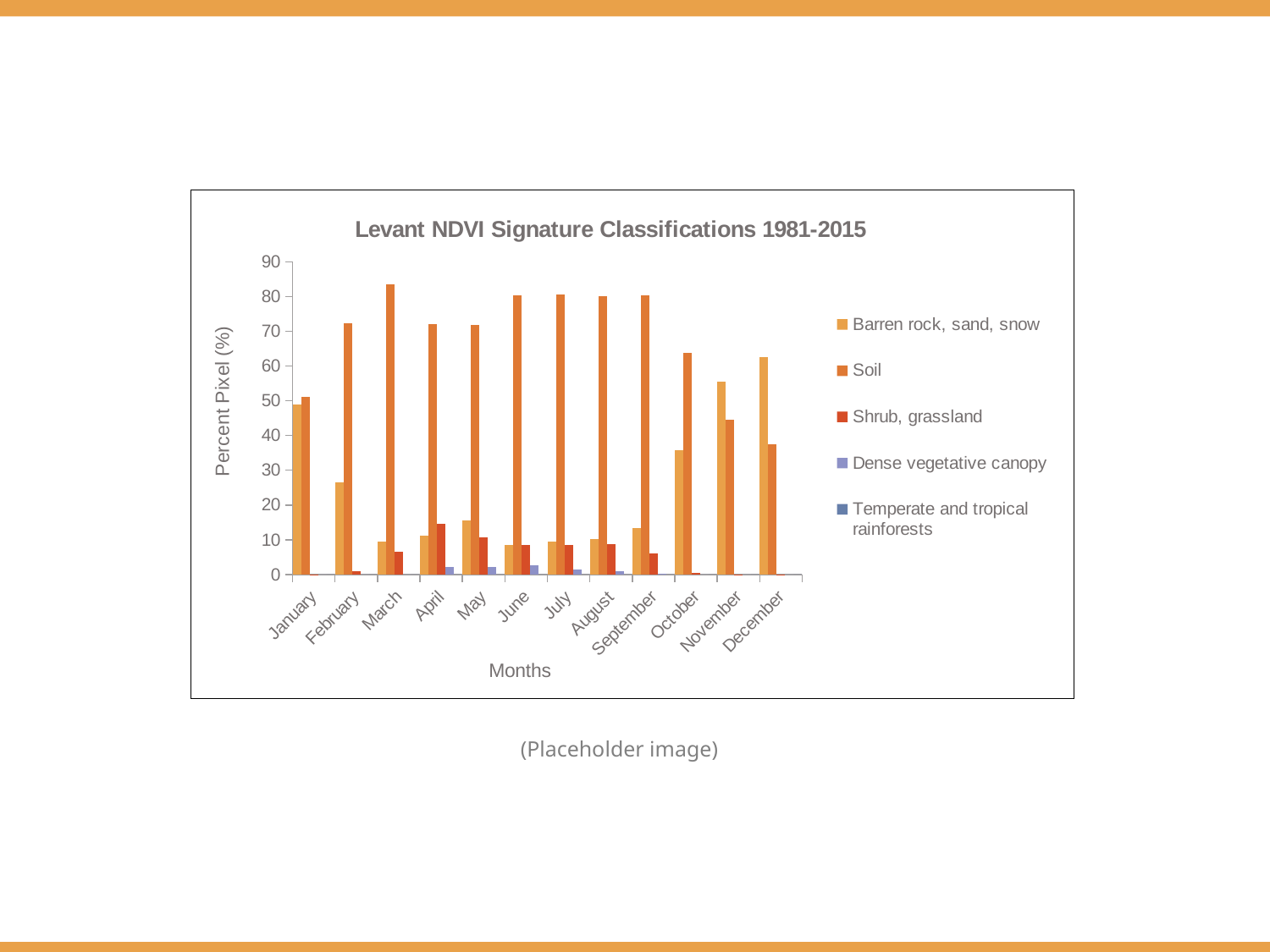
In December, which is larger: Barren rock, sand, snow or Soil? Barren rock, sand, snow What kind of chart is shown on the slide? Bar chart Is the Barren rock, sand, snow value for October greater or less than 40? less Is the Soil value for March greater or less than 80? greater Which month has the larger Shrub, grassland value: April or May? April How many series does the legend of the chart list? 5 How many months are shown along the x axis of the chart? 12 In which month is the Shrub, grassland value highest? April Is the Barren rock, sand, snow value for November greater or less than 50? greater In which month is the Barren rock, sand, snow value highest? December Does the Soil value rise or fall from September to December? Fall In which month is the Soil value highest? March